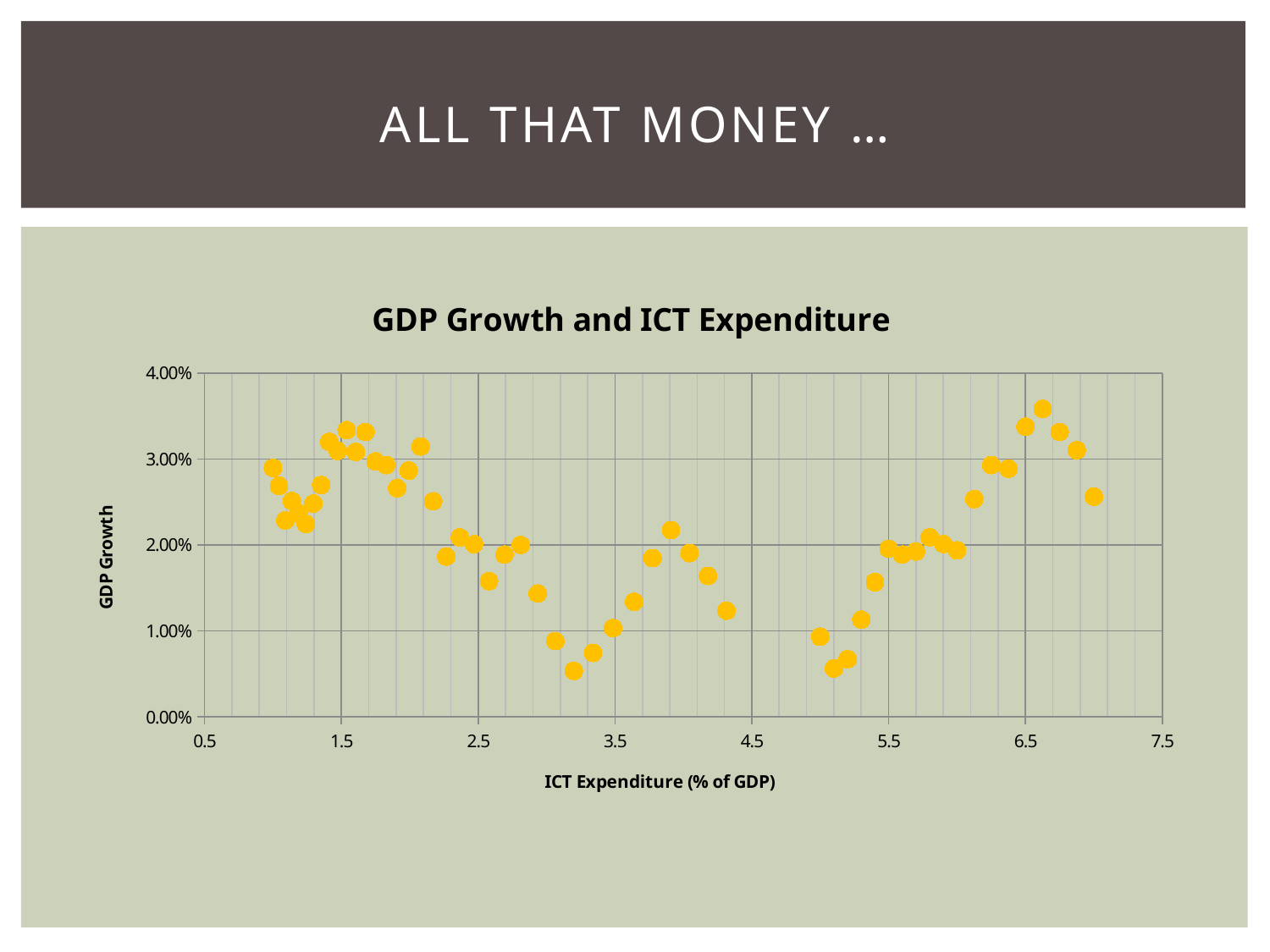
Is the GDP growth of the point with the lowest ICT expenditure greater or less than 2.00%? greater What kind of chart is shown on the slide? Scatter chart What is the label of the horizontal axis of the chart? ICT Expenditure (% of GDP) Is the GDP growth of the highest point on the chart greater or less than 3.00%? greater Is the GDP growth of the point with the highest ICT expenditure greater or less than 2.00%? greater What is the title of the chart? GDP Growth and ICT Expenditure Between ICT expenditure of 5.0 and 6.5, do the GDP growth values generally rise or fall? rise Between ICT expenditure of 1.5 and 3.5, do the GDP growth values generally rise or fall? fall